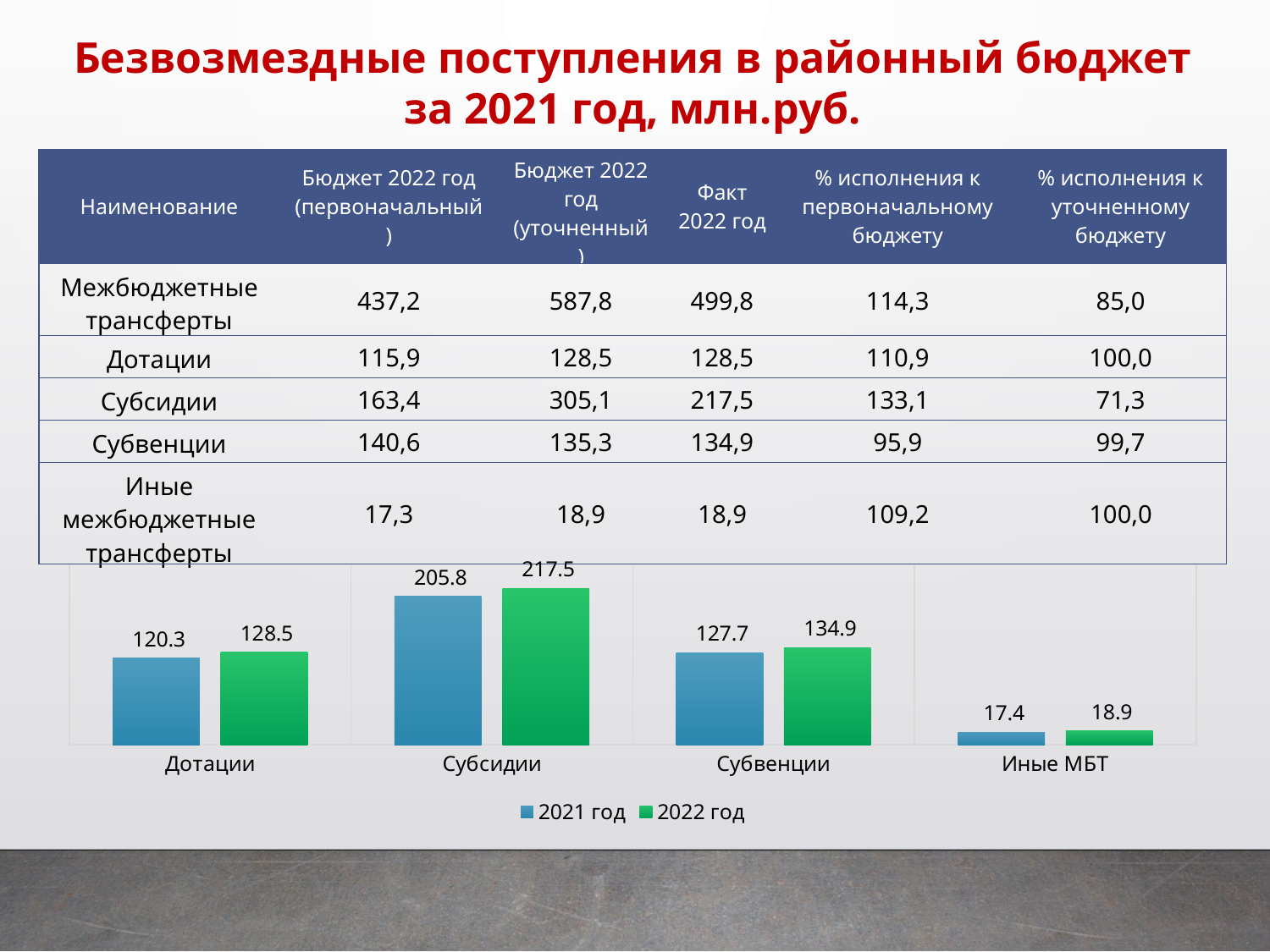
Which is larger for Субсидии: the 2021 год value or the 2022 год value? 2022 год What is the value for Субсидии in the 2022 год series? 217.5 Which colour represents the 2022 год series in the chart? green What is the difference between the 2022 год and 2021 год values for Дотации? 8.2 What kind of chart is shown at the bottom of the slide? bar chart How many categories are shown on the chart's x axis? 4 Which category has the lowest value in the 2022 год series? Иные МБТ What is the value for Дотации in the 2021 год series? 120.3 What is the difference between the 2022 год and 2021 год values for Субвенции? 7.2 Which category has the highest value in the 2021 год series? Субсидии How many series does the chart legend list? 2 What is the value for Иные МБТ in the 2022 год series? 18.9